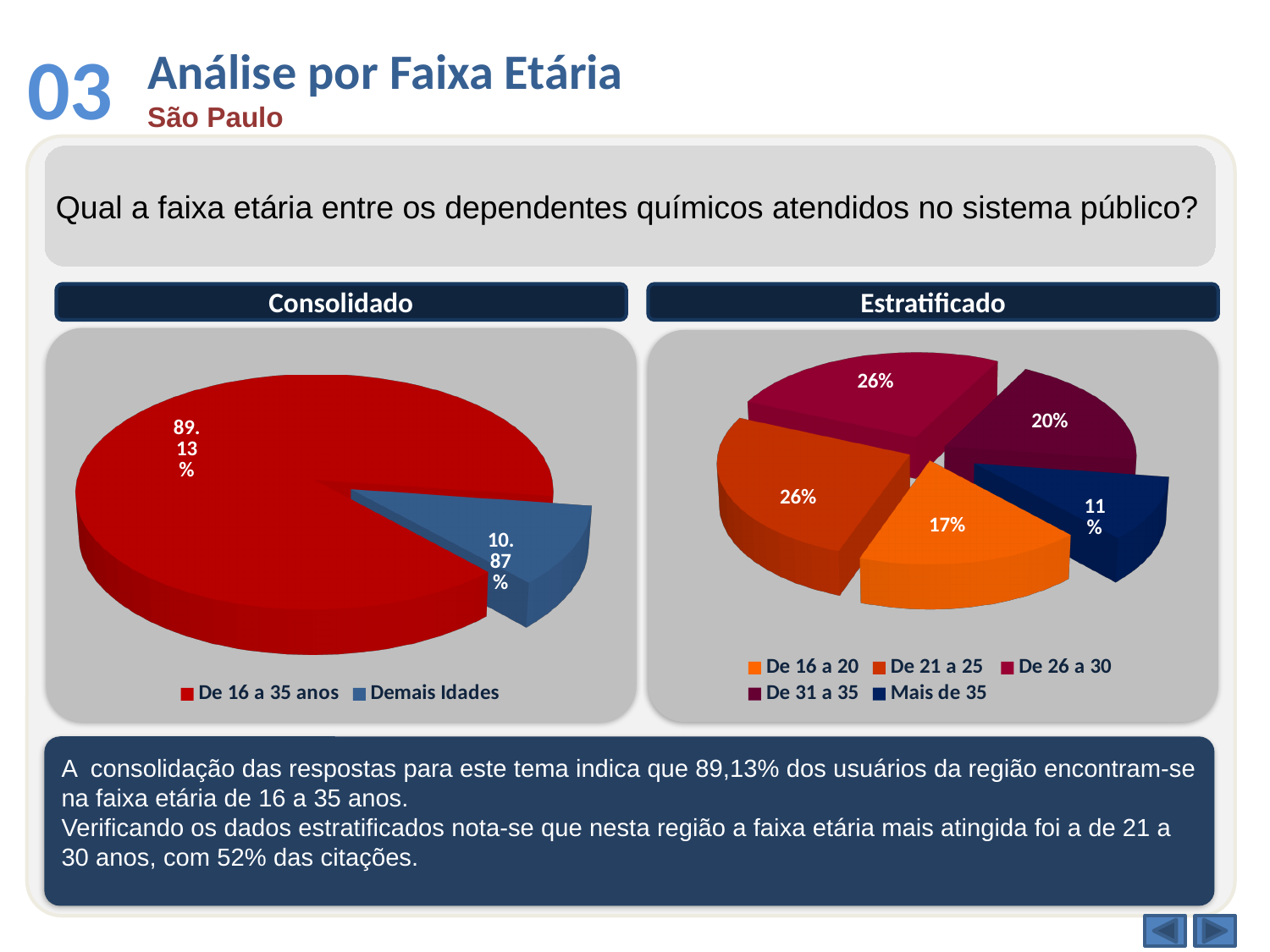
In the Estratificado chart, which category has the smallest share? Mais de 35 How many categories does the legend of the Estratificado chart list? 5 In the Consolidado chart, what is the difference between the De 16 a 35 anos share and the Demais Idades share? 78.26% In the Estratificado chart, which is larger: De 21 a 25 or De 16 a 20? De 21 a 25 In the Estratificado chart, what is the combined share of De 21 a 25 and De 26 a 30? 52% In the Consolidado chart, what percentage is shown for De 16 a 35 anos? 89.13% In the Estratificado chart, what percentage is shown for De 31 a 35? 20% In the Estratificado chart, what percentage is shown for Mais de 35? 11% In the Estratificado chart, what percentage is shown for De 16 a 20? 17% In the Consolidado chart, which category has the larger share? De 16 a 35 anos What kind of chart is the Estratificado chart? Pie chart In the Consolidado chart, what percentage is shown for Demais Idades? 10.87%